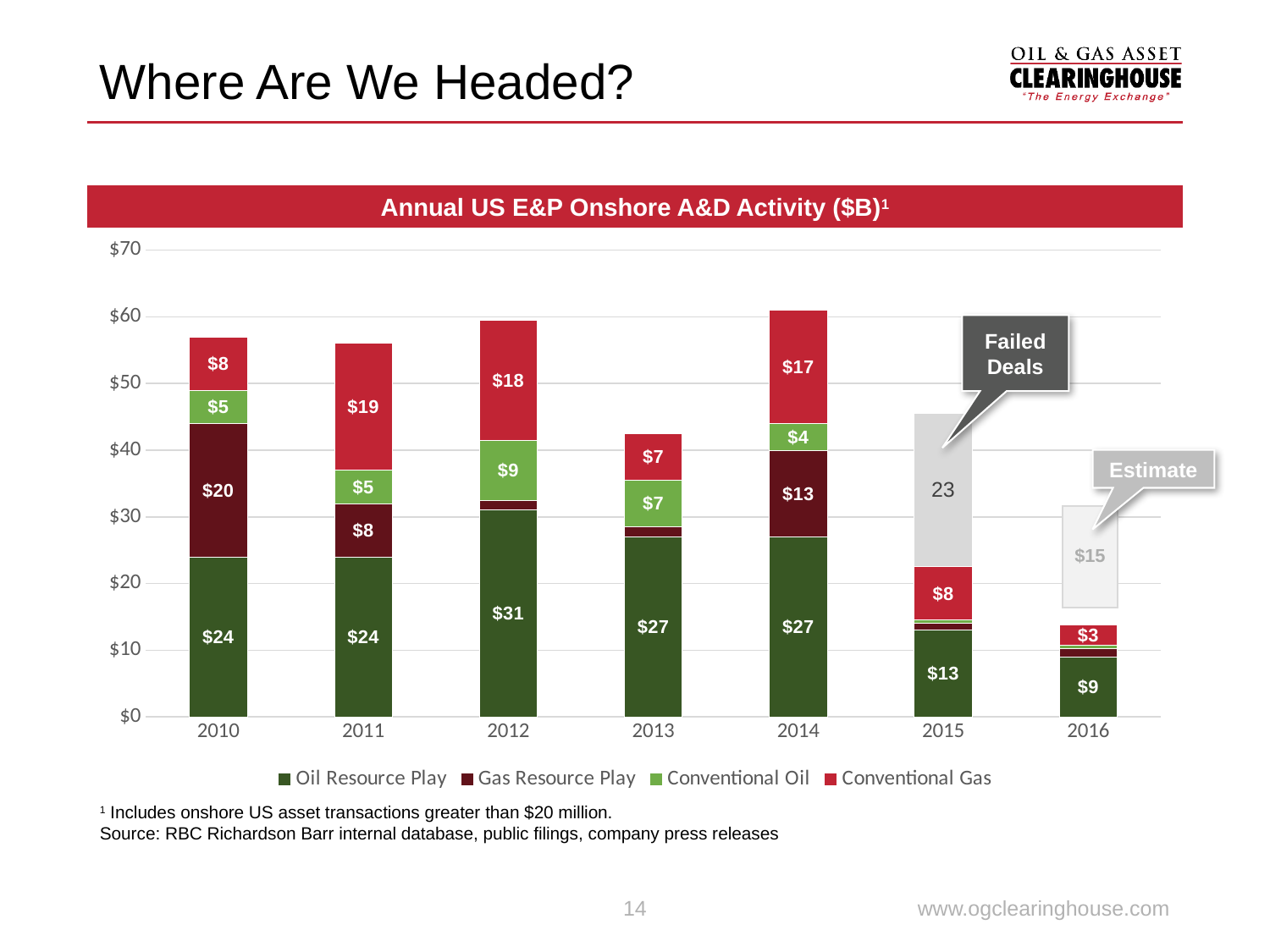
What is the difference between the Conventional Gas values for 2014 and 2016? $14 What is the value for Oil Resource Play in 2012? $31 Which year has the highest Oil Resource Play value? 2012 Is the total of the stacked bar for 2013 greater or less than $40? greater What is the total of the stacked bar for 2014? $61 What is the value for Gas Resource Play in 2014? $13 Which year has the lowest Oil Resource Play value? 2016 What value is shown for Failed Deals in 2015? 23 Which year has the larger Gas Resource Play value, 2010 or 2011? 2010 How many years are shown on the x axis? 7 What is the value for Conventional Gas in 2011? $19 How many series does the legend list? 4